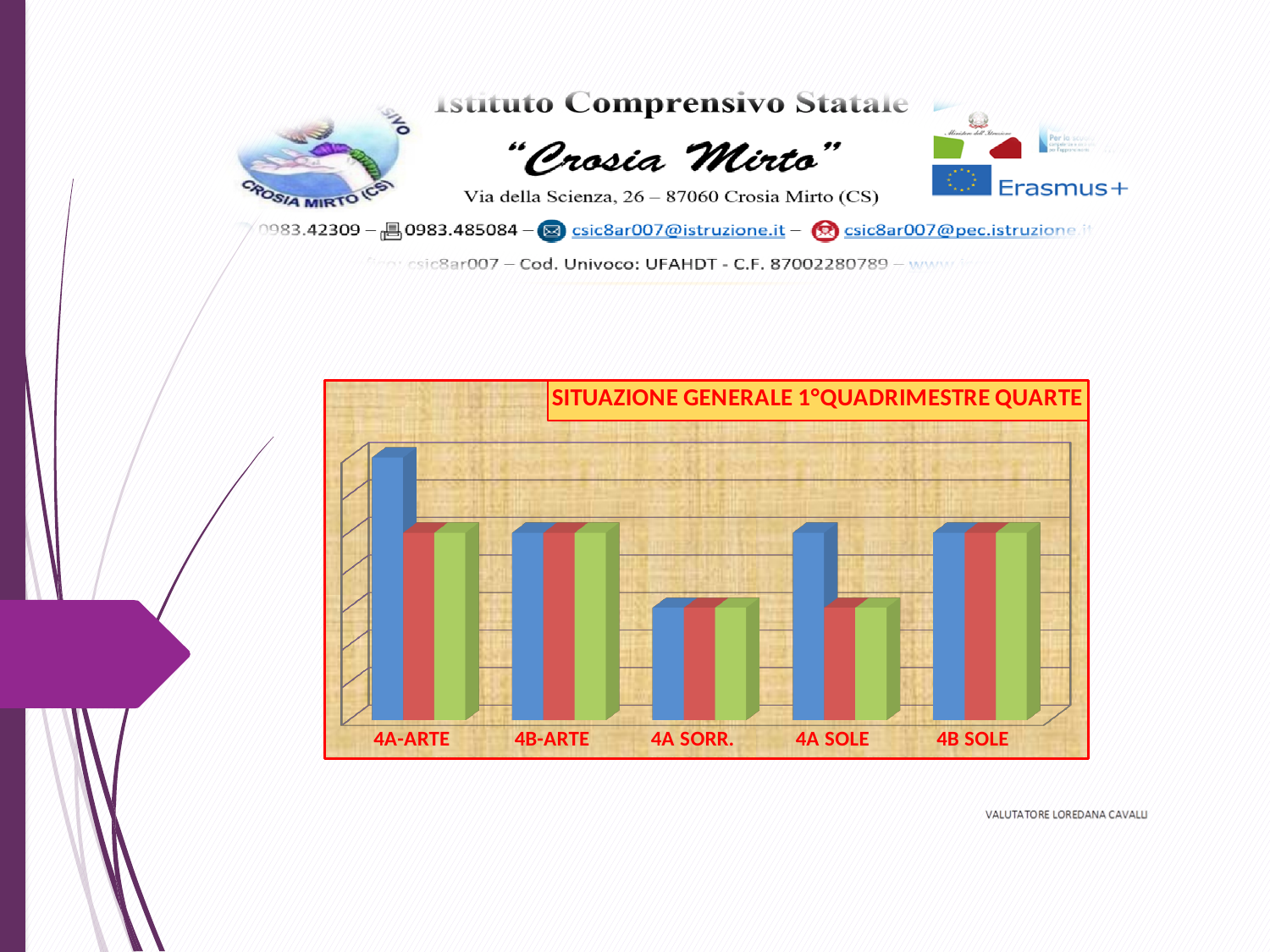
Which category has the lowest bars overall in the chart? 4A SORR. Is the blue bar for 4A-ARTE taller or shorter than the blue bar for 4B-ARTE? taller Which category has the tallest bar in the chart? 4A-ARTE How many bars are plotted for each category in the chart? 3 How many categories are shown on the x axis of the chart? 5 What is the title of the chart? SITUAZIONE GENERALE 1°QUADRIMESTRE QUARTE What kind of chart is shown on the slide? bar chart Is the blue bar for 4A SOLE taller or shorter than the red bar for 4A SOLE? taller Which category is listed first on the x axis of the chart? 4A-ARTE Is the green bar for 4A SORR. taller or shorter than the green bar for 4B SOLE? shorter